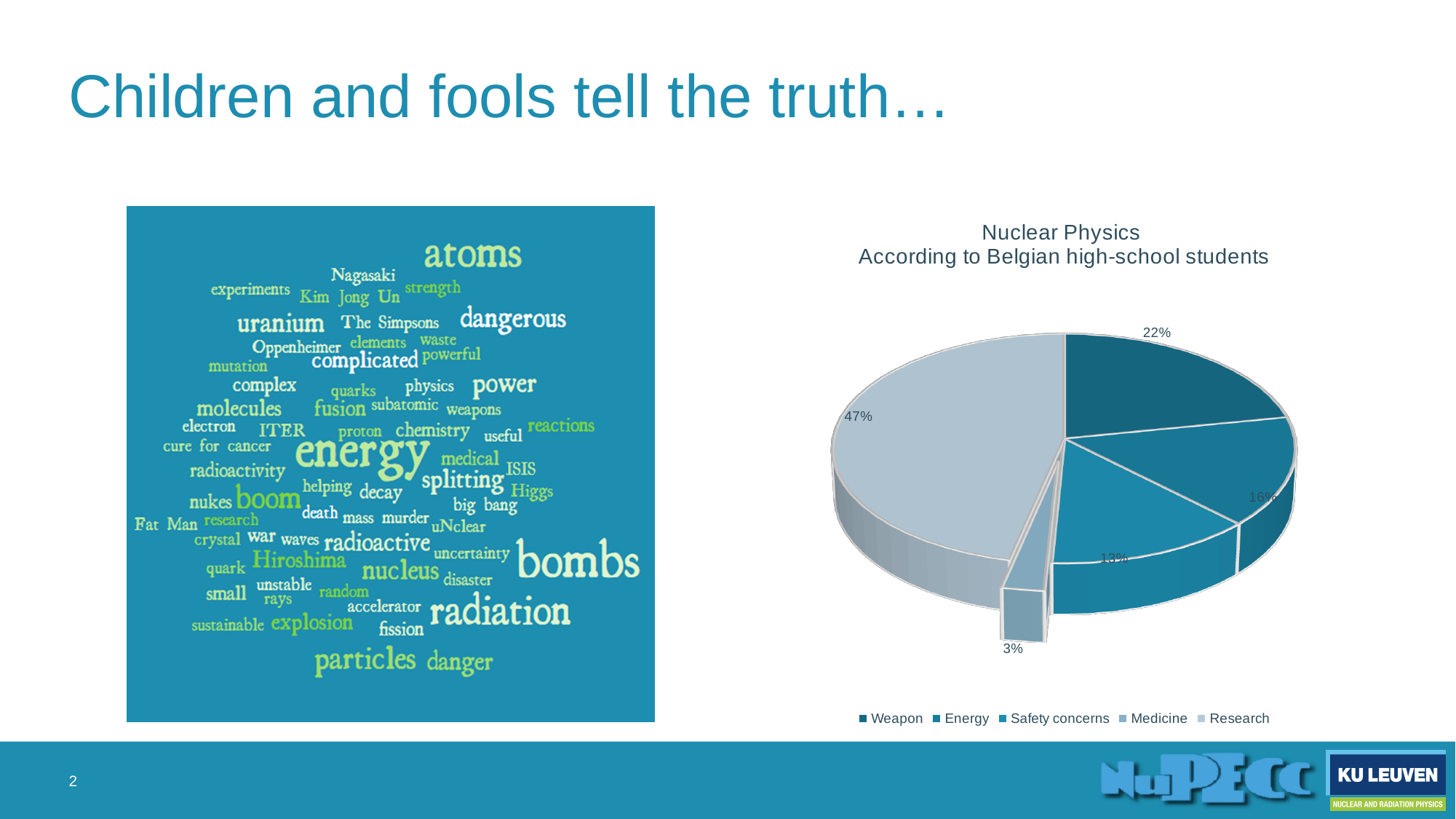
Which category has the smallest slice in the pie chart? Medicine What type of chart is shown on the slide? pie chart How many categories does the legend of the pie chart list? 5 What percentage of the pie chart is Safety concerns? 13% What percentage of the pie chart is Weapon? 22% What is the title of the pie chart? Nuclear Physics According to Belgian high-school students What is the difference in percentage points between Research and Weapon in the pie chart? 25 What percentage of the pie chart is Research? 47% What percentage of the pie chart is Medicine? 3% Which is larger in the pie chart, Energy or Safety concerns? Energy What percentage of the pie chart is Energy? 16% Which category has the largest slice in the pie chart? Research